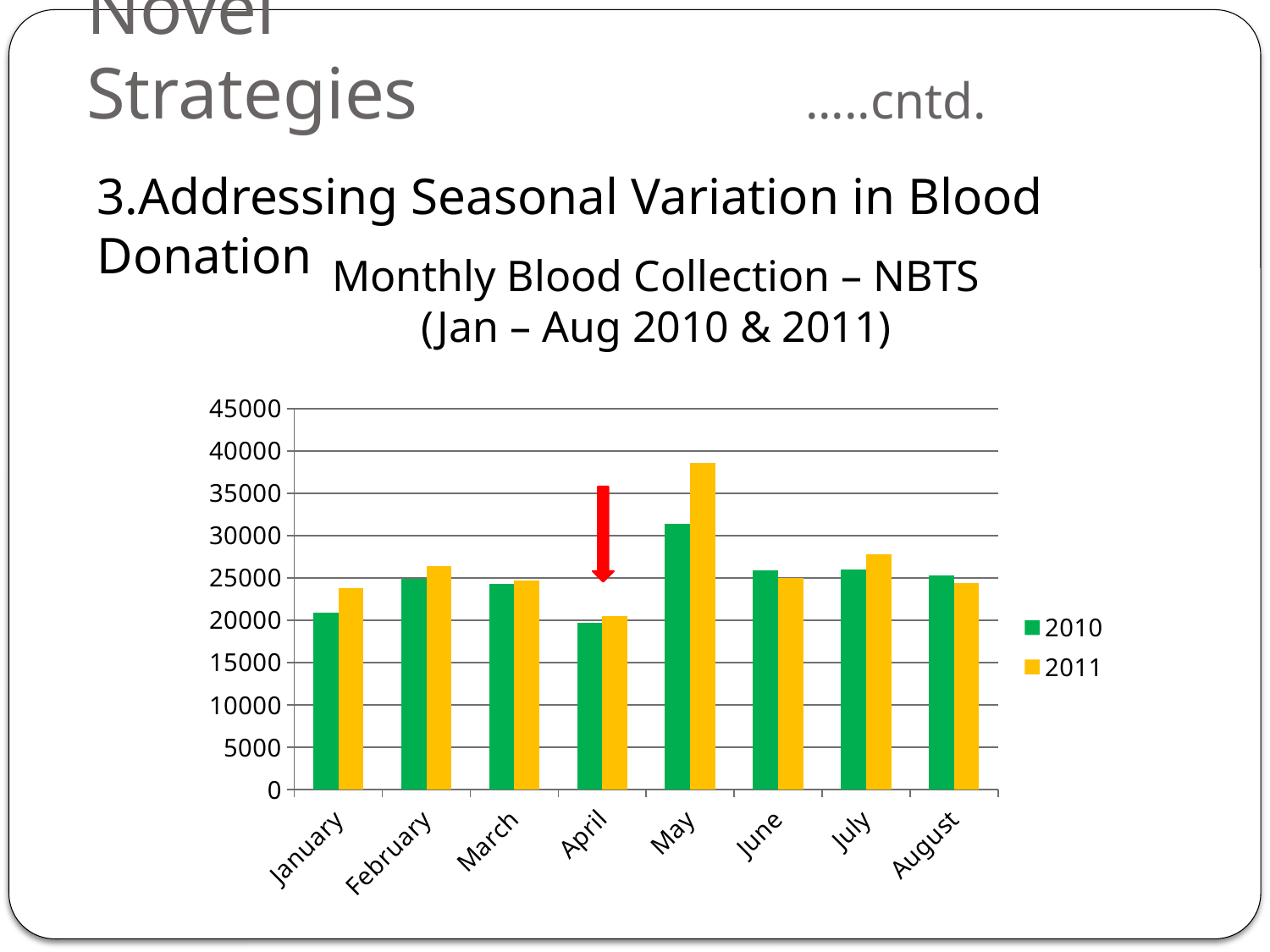
Which month has the lowest value for the 2011 series? April How many months are shown on the x axis? 8 Is the value for April in the 2010 series greater or less than 25000? less How many series does the legend list? 2 Which month has the lowest value for the 2010 series? April Is the value for May in the 2011 series greater or less than 35000? greater Which month has the highest value for the 2010 series? May Which month has the highest value for the 2011 series? May In January, which series has the larger value, 2010 or 2011? 2011 What is the title of the chart? Monthly Blood Collection – NBTS (Jan – Aug 2010 & 2011) In May, which series has the larger value, 2010 or 2011? 2011 What kind of chart is shown on the slide? bar chart